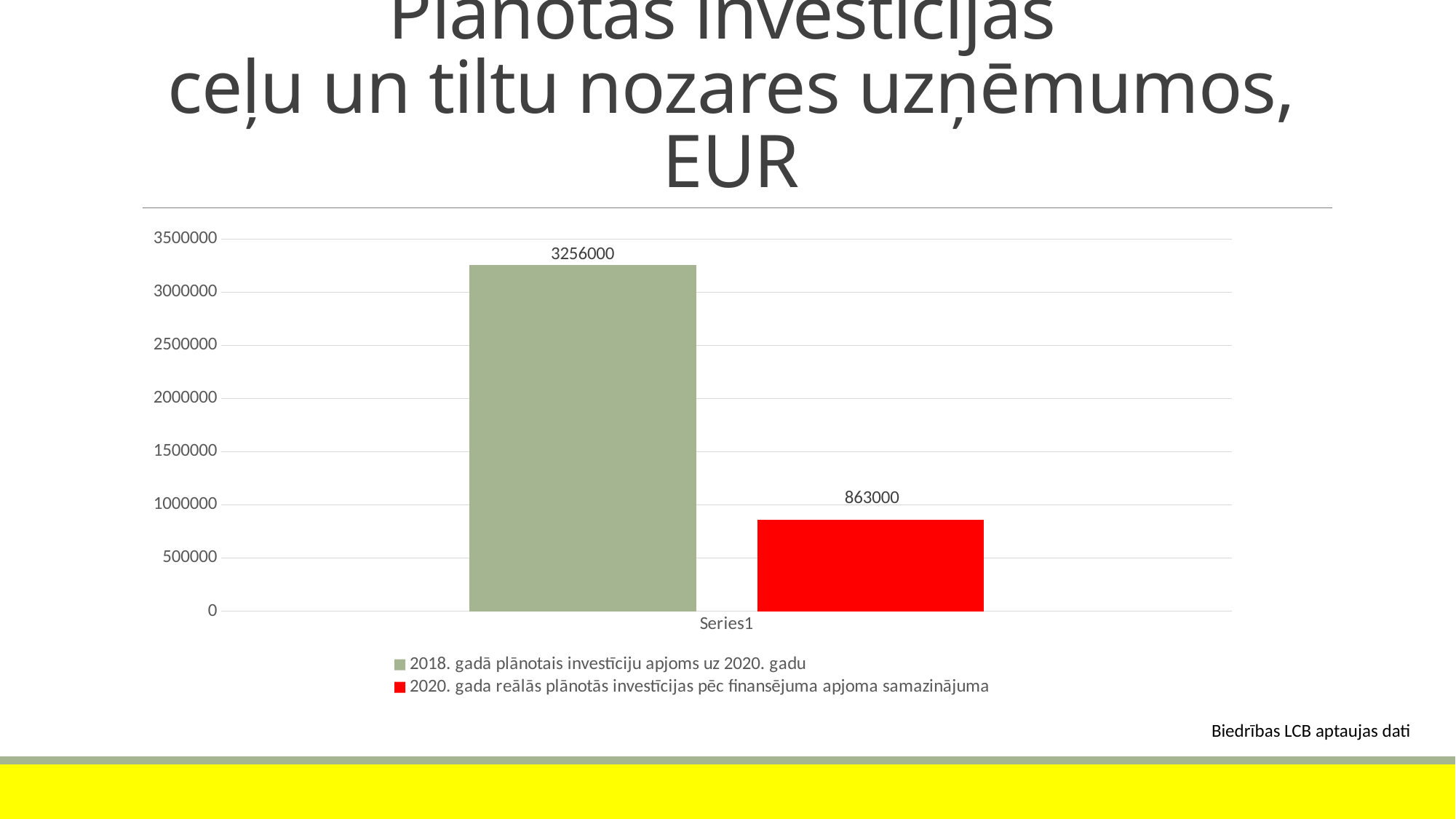
Is the value for the red bar greater or less than 1000000? less What is the value of the bar for '2020. gada reālās plānotās investīcijas pēc finansējuma apjoma samazinājuma'? 863000 What is the value of the bar for '2018. gadā plānotais investīciju apjoms uz 2020. gadu'? 3256000 How many bars are plotted on the chart? 2 Which series has the higher value? 2018. gadā plānotais investīciju apjoms uz 2020. gadu What is the difference between the 2018 planned investment value and the 2020 real planned investment value? 2393000 What colour is the bar for '2020. gada reālās plānotās investīcijas pēc finansējuma apjoma samazinājuma'? red What kind of chart is shown on the slide? bar chart Is the value for the green bar greater or less than 3000000? greater How many series does the legend list? 2 What is the category label shown on the x axis? Series1 Which series has the lower value? 2020. gada reālās plānotās investīcijas pēc finansējuma apjoma samazinājuma